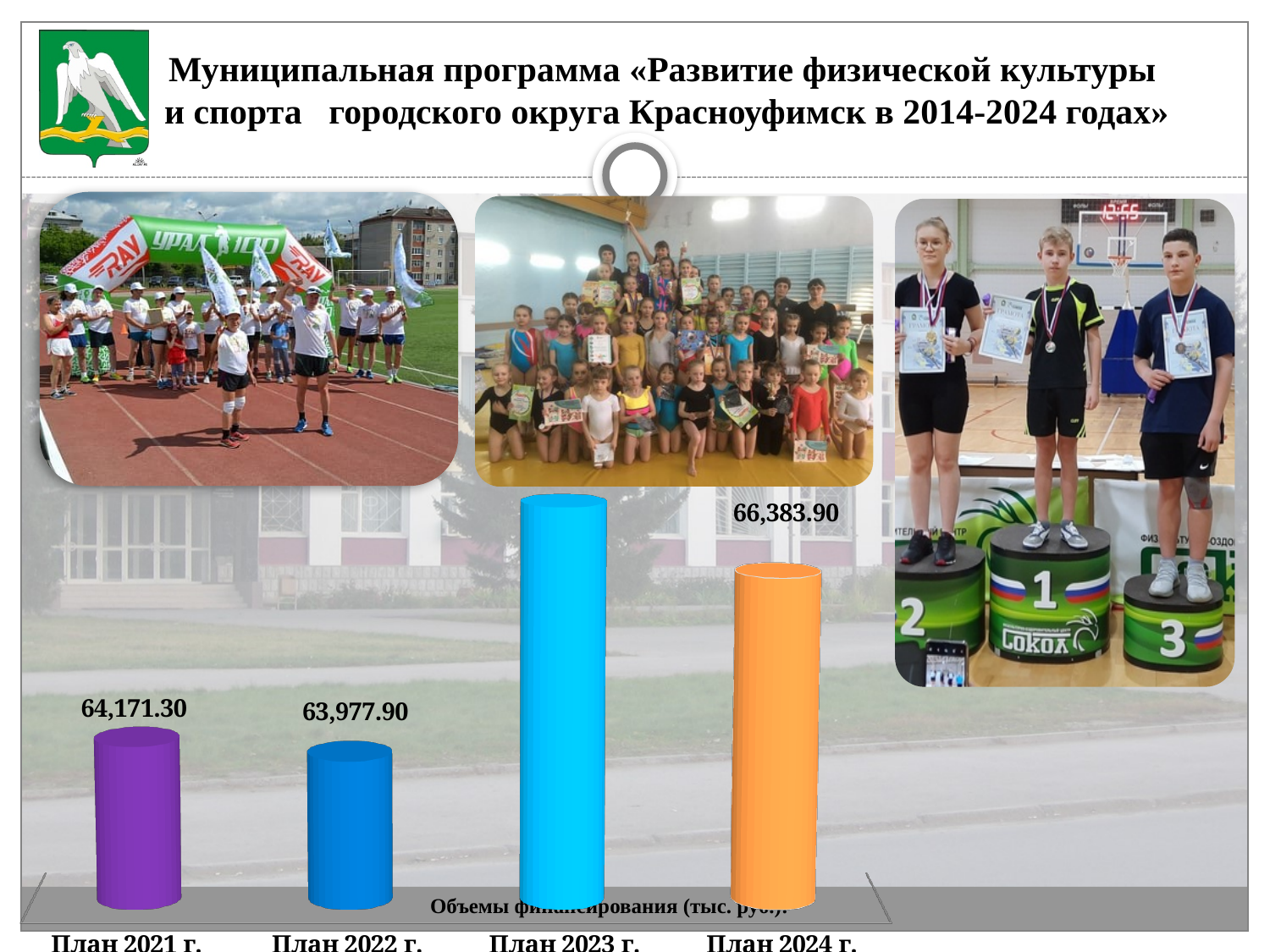
What is the difference between the values for План 2021 г. and План 2022 г.? 193.40 What is the difference between the values for План 2024 г. and План 2021 г.? 2,212.60 Which category has the tallest bar in the financing chart? План 2023 г. How many categories are shown in the financing chart? 4 What kind of chart is used to show the financing volumes? Bar chart What is the difference between the values for План 2024 г. and План 2022 г.? 2,406.00 Which is larger, the value for План 2021 г. or the value for План 2022 г.? План 2021 г. What is the value for План 2022 г. in the financing chart? 63,977.90 What is the value for План 2024 г. in the financing chart? 66,383.90 Which category has the lowest value in the financing chart? План 2022 г. Which is larger, the value for План 2024 г. or the value for План 2021 г.? План 2024 г. What is the value for План 2021 г. in the financing chart? 64,171.30